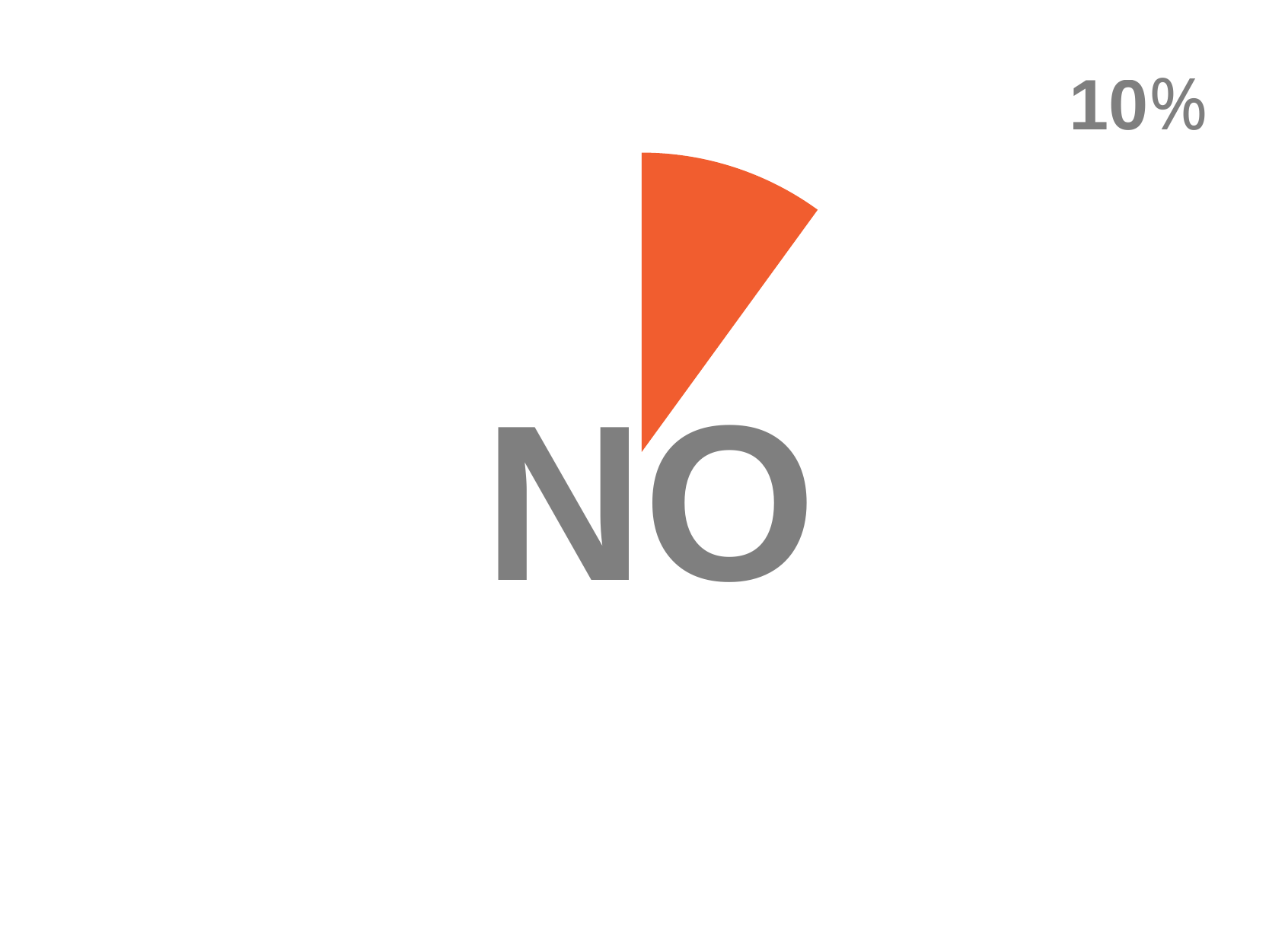
What percentage value is printed on the slide next to the orange pie slice? 10% What word is printed in large grey letters below the pie slice? NO What kind of chart is shown on the slide? pie chart How many coloured slices are visible in the pie chart? 1 What colour is the visible slice of the pie chart? orange